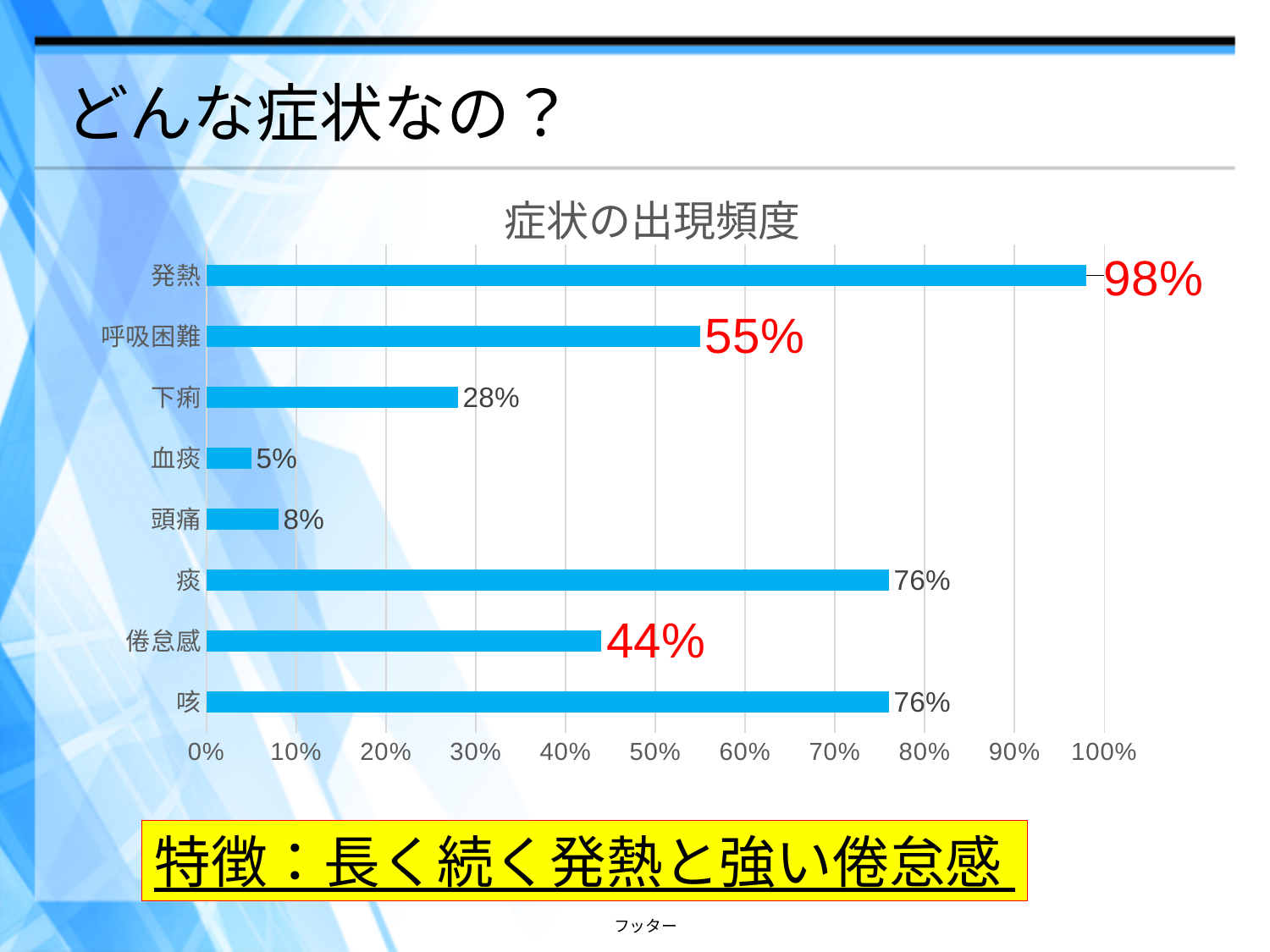
Which category has the highest value? 発熱 How many categories are shown in the chart? 8 What is the value for 倦怠感? 44% Is the value for 痰 greater or less than 70%? greater What is the title of the chart? 症状の出現頻度 What is the value for 呼吸困難? 55% Which category has the lowest value? 血痰 What is the difference between the values for 発熱 and 呼吸困難? 43% What kind of chart is shown on the slide? bar chart Which is larger, the value for 下痢 or the value for 倦怠感? 倦怠感 What is the value for 発熱? 98% What is the value for 血痰? 5%